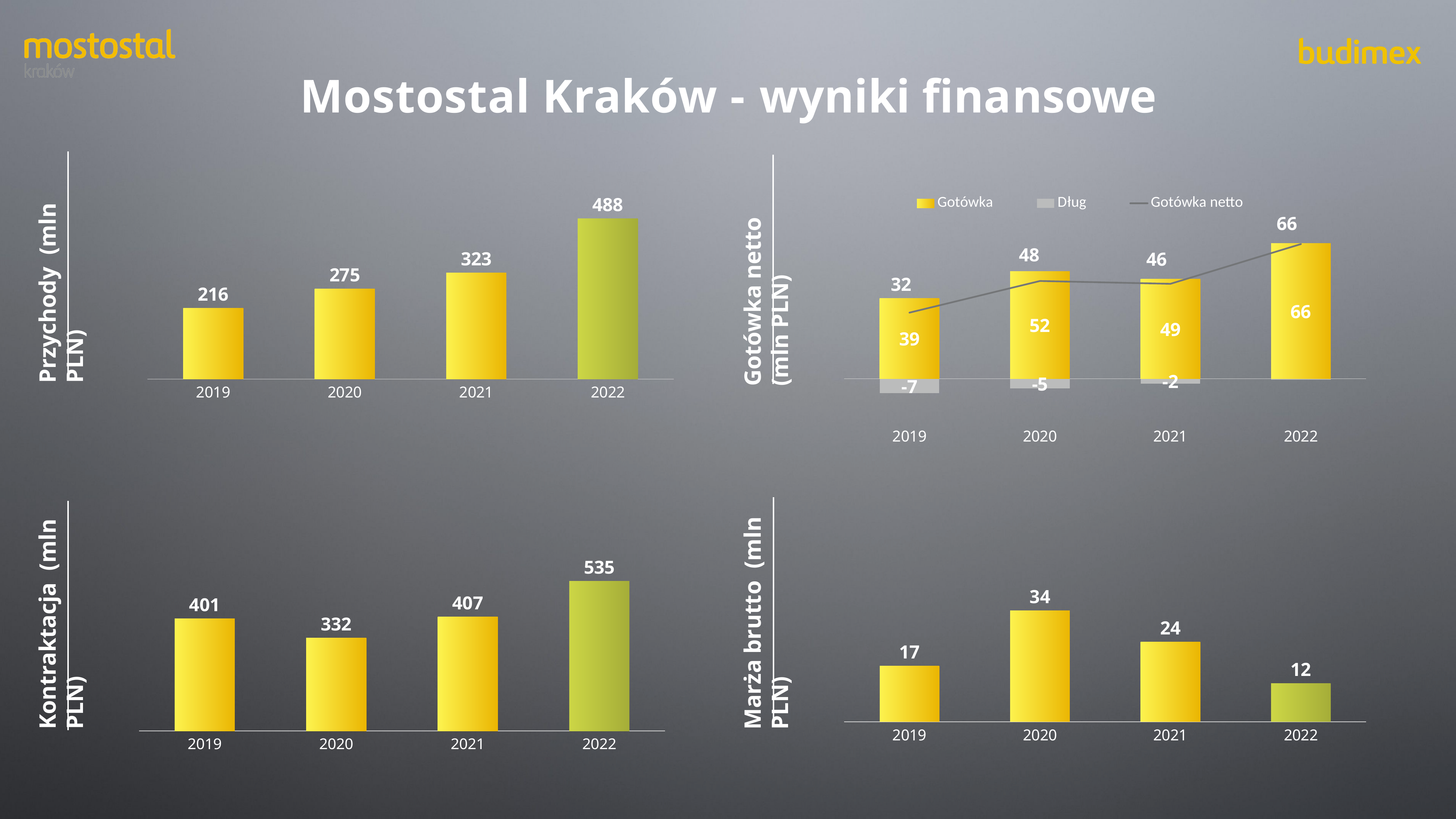
How many years are shown on the x axis of the Marża brutto (mln PLN) chart? 4 In the Gotówka netto (mln PLN) chart, how many series does the legend list? 3 In the Marża brutto (mln PLN) chart, what is the value for 2020? 34 In the Kontraktacja (mln PLN) chart, what is the value for 2020? 332 In the Marża brutto (mln PLN) chart, which year has the lowest value? 2022 In the Przychody (mln PLN) chart, what is the value for 2022? 488 In the Kontraktacja (mln PLN) chart, which year has the highest value? 2022 In the Przychody (mln PLN) chart, do the values rise or fall from 2019 to 2022? rise In the Kontraktacja (mln PLN) chart, which is larger, the value for 2019 or 2021? 2021 In the Przychody (mln PLN) chart, which year has the lowest value? 2019 In the Gotówka netto (mln PLN) chart, what is the Dług value for 2019? -7 In the Przychody (mln PLN) chart, what is the difference between the 2022 and 2021 values? 165